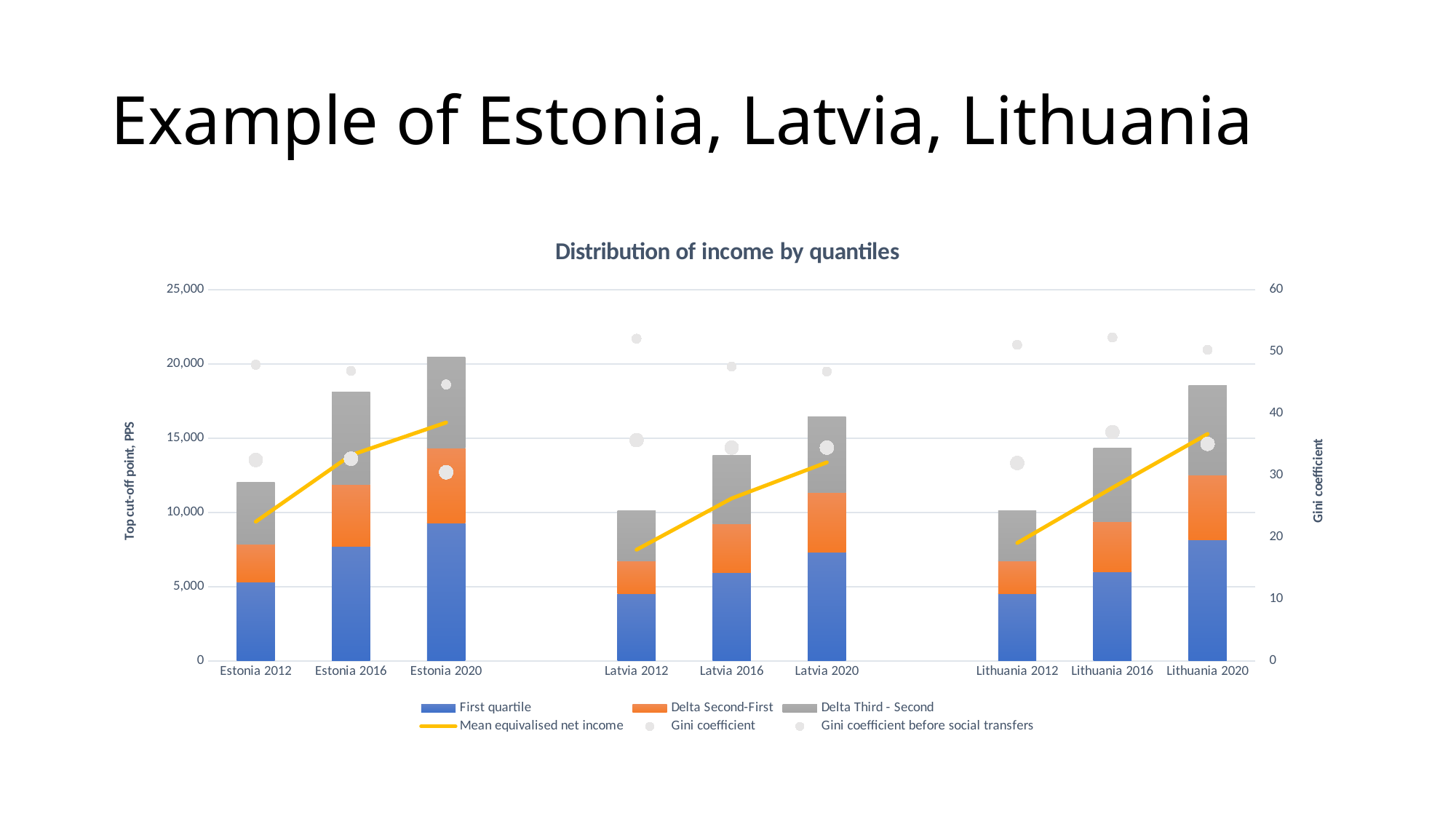
Which stacked bar is taller, Estonia 2016 or Latvia 2016? Estonia 2016 Is the total of the stacked bar for Latvia 2020 greater or less than 15,000? greater How many series does the legend list? 6 Does the Mean equivalised net income line for Lithuania rise or fall from 2012 to 2020? rise How many categories are shown on the x axis? 9 What kind of chart is used to show the quartile values? Bar chart (stacked) Is the First quartile value for Estonia 2020 greater or less than 10,000? less Is the total of the stacked bar for Estonia 2016 greater or less than 20,000? less What is the title of the chart? Distribution of income by quantiles Which category has the tallest stacked bar? Estonia 2020 What is the label of the left vertical axis? Top cut-off point, PPS